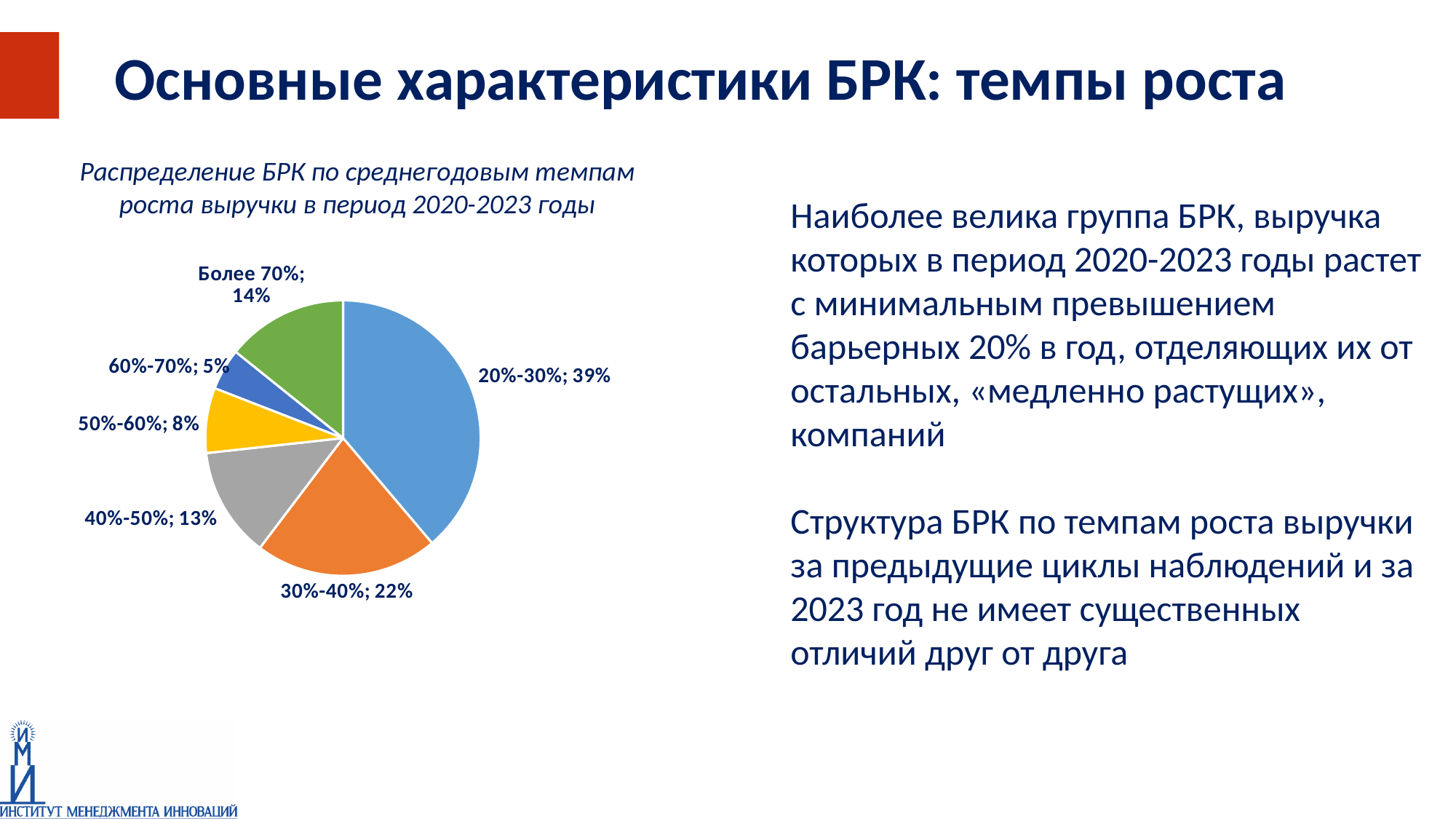
Which slice is larger: 50%-60% or 'Более 70%'? Более 70% What is the difference between the shares of the 20%-30% and 30%-40% categories? 17% What kind of chart is shown on the slide? pie chart What share of the pie does the 30%-40% category have? 22% Which category has the largest slice of the pie? 20%-30% What share of the pie does the 40%-50% category have? 13% How many slices does the pie chart have? 6 Which category has the smallest slice of the pie? 60%-70% What share of the pie does the 'Более 70%' category have? 14% What is the combined share of the 50%-60% and 60%-70% categories? 13% What share of the pie does the 20%-30% category have? 39% What colour is the slice for the 30%-40% category? orange